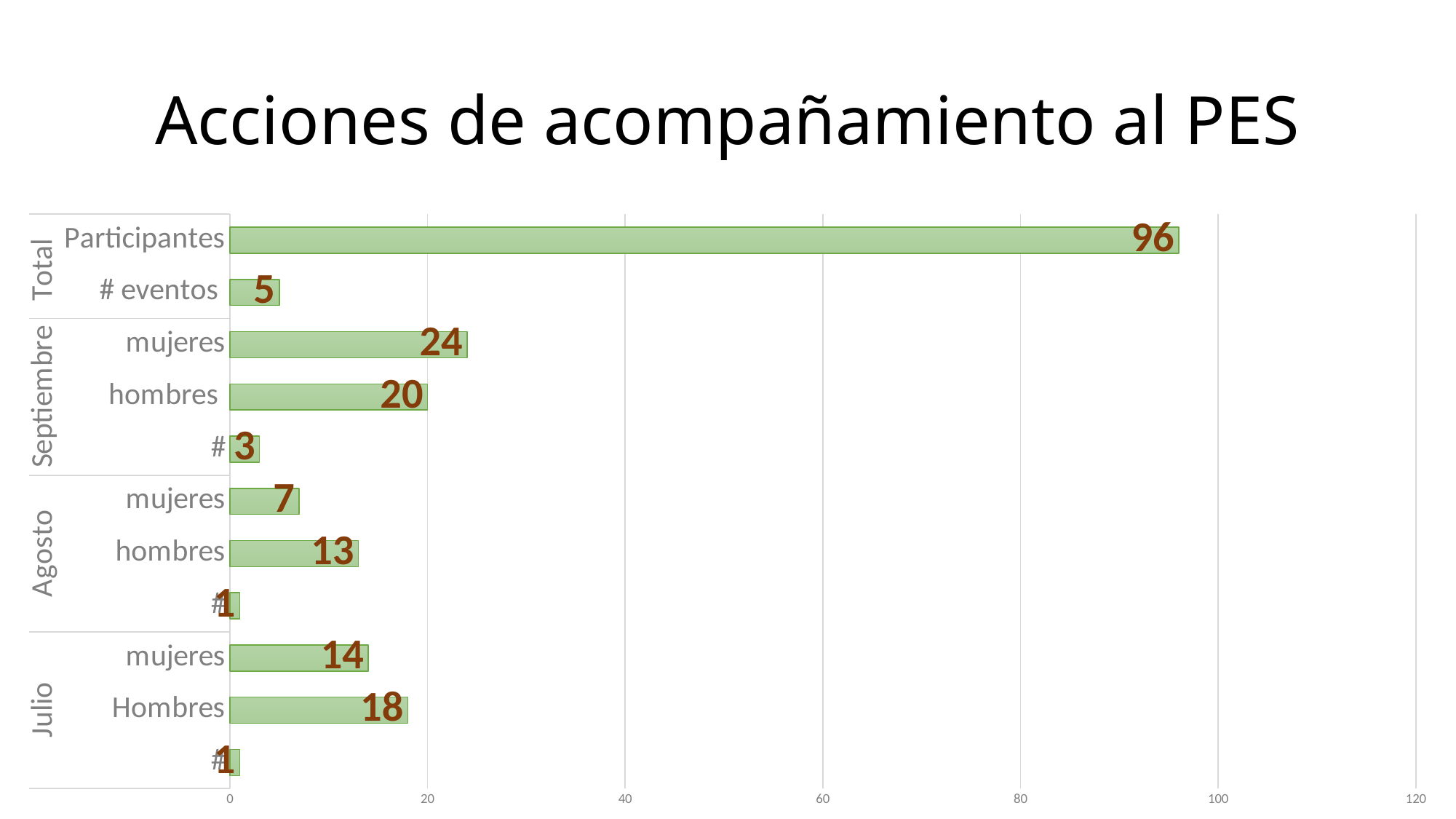
What is the value for Participantes under Total? 96 What is the value for mujeres in Septiembre? 24 What is the difference between mujeres and hombres in Septiembre? 4 Which category has the highest value? Participantes Is the value for Participantes greater or less than 80? greater What kind of chart is shown on the slide? bar chart Which is larger in Agosto, mujeres or hombres? hombres What is the value for # eventos under Total? 5 What is the value for hombres in Agosto? 13 Which is larger, mujeres in Julio or mujeres in Septiembre? mujeres in Septiembre How many bars are plotted in the chart? 11 What is the value for Hombres in Julio? 18